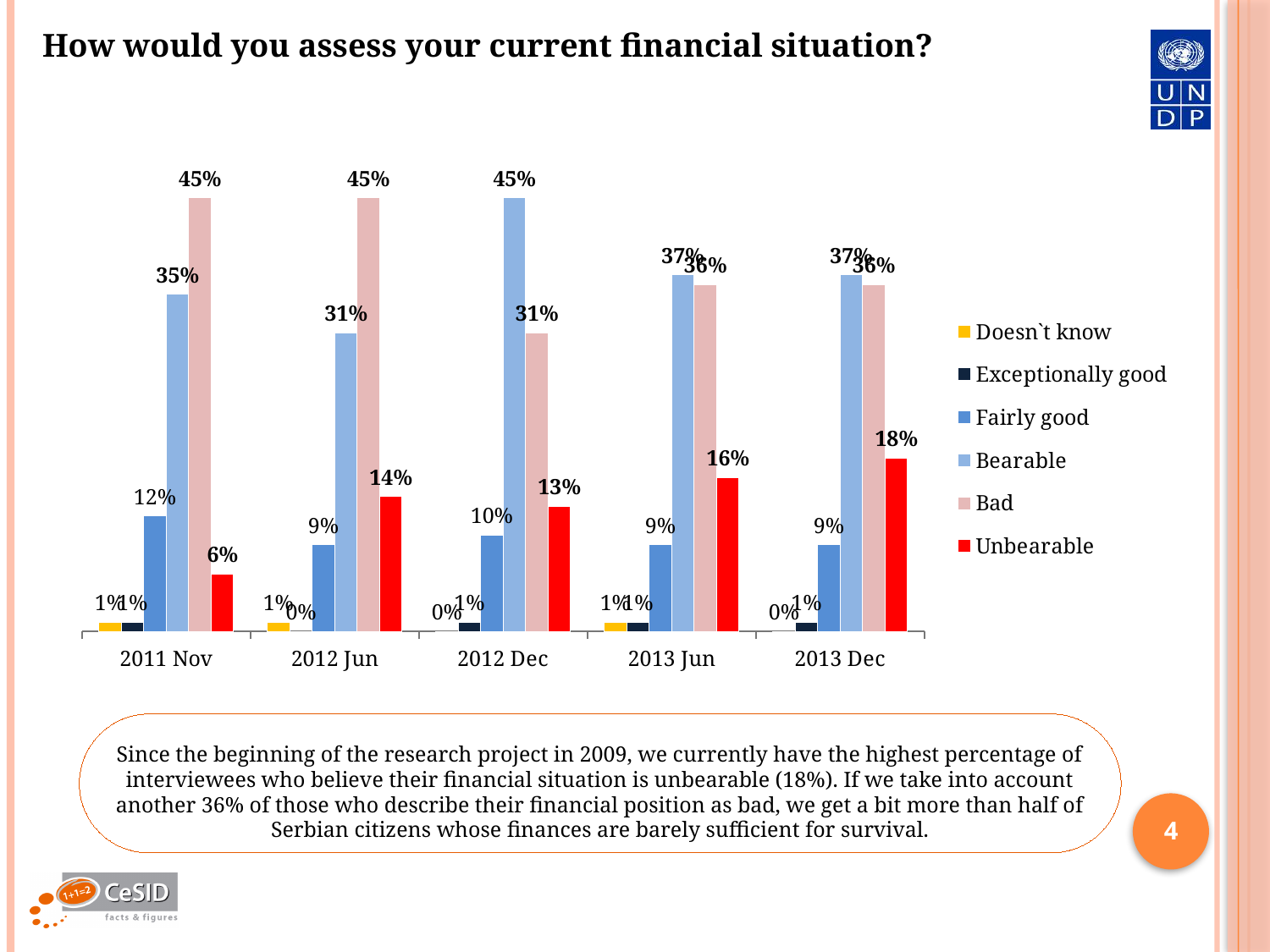
What kind of chart is shown on the slide? Bar chart Does the Unbearable value rise or fall from 2012 Dec to 2013 Dec? Rise What is the difference between the Unbearable values in 2013 Dec and 2011 Nov? 12% How many series does the legend list? 6 What is the value for Bearable in 2011 Nov? 35% What is the value for Fairly good in 2011 Nov? 12% In which survey wave was the Unbearable value highest? 2013 Dec How many survey waves are shown on the x axis? 5 What percentage of respondents described their financial situation as Unbearable in 2013 Dec? 18% Which is larger in 2012 Dec: Bearable or Bad? Bearable What is the value for Bad in 2012 Dec? 31% In which survey wave was the Unbearable value lowest? 2011 Nov